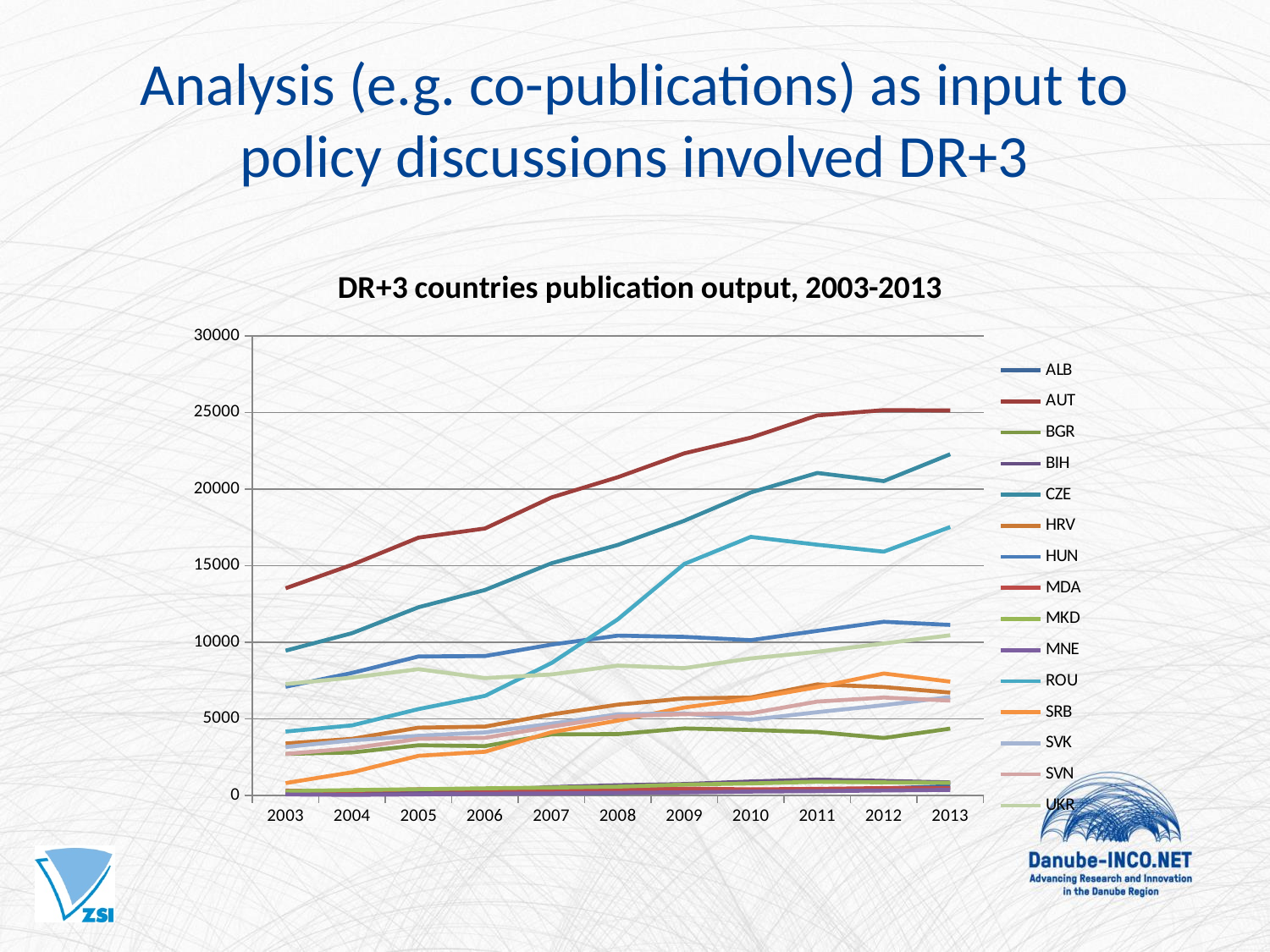
What kind of chart is shown on the slide? line chart How many years are shown along the x axis? 11 What is the title of the chart? DR+3 countries publication output, 2003-2013 In 2013, which has the larger publication output, HUN or ROU? ROU Is the value for AUT in 2003 greater or less than 10000? greater How many series does the legend list? 15 Does the publication output for AUT rise or fall from 2003 to 2013? rise Is the value for CZE in 2013 greater or less than 20000? greater Which country has the highest publication output in 2013? AUT Does the publication output for ROU rise or fall from 2003 to 2013? rise In 2013, which has the larger publication output, AUT or CZE? AUT Is the value for ROU in 2003 greater or less than 5000? less